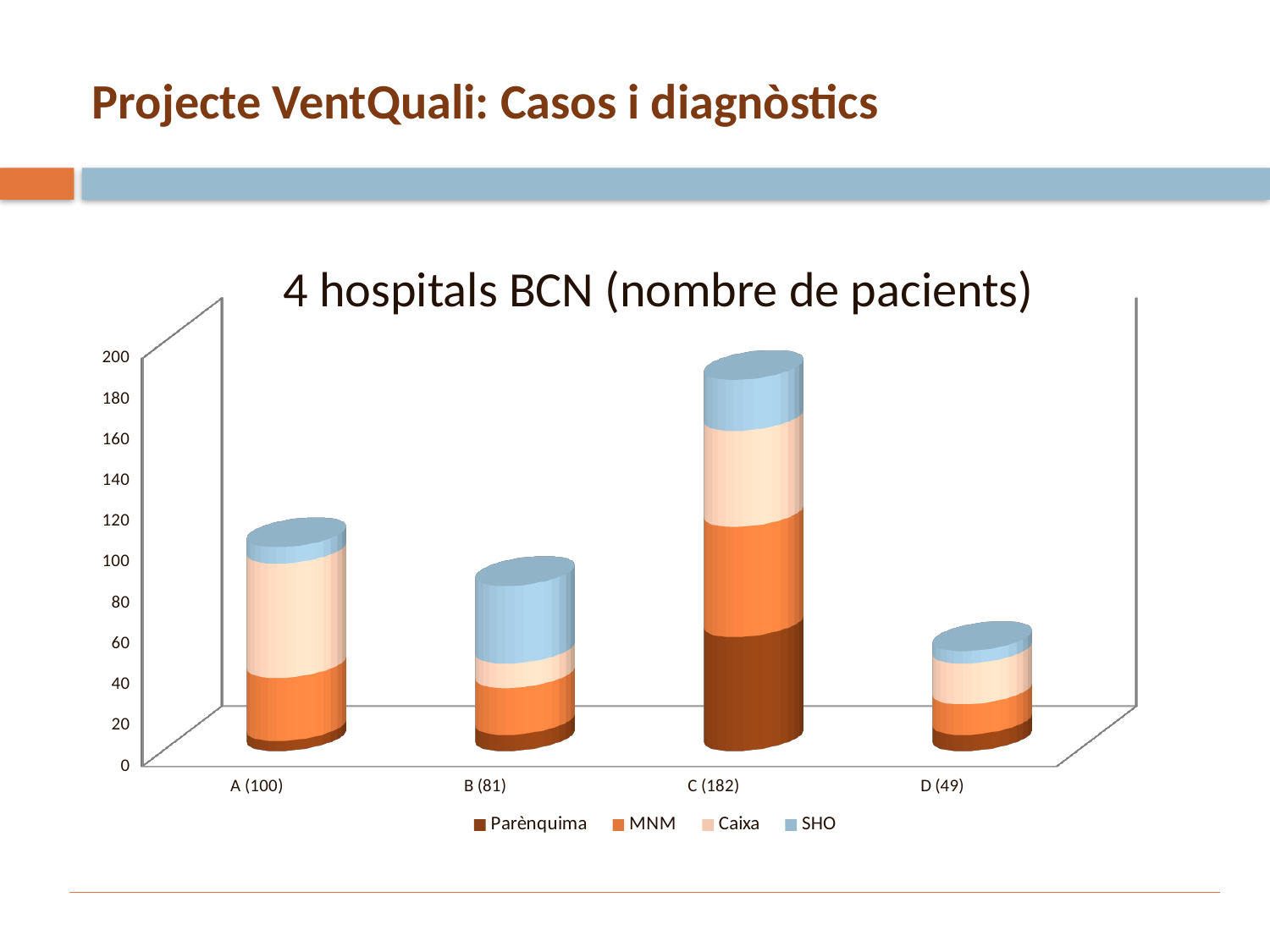
How many series does the legend list? 4 Which hospital has the highest total number of patients? C (182) Which hospital has the lowest total number of patients? D (49) How many hospitals (categories) are shown on the x axis? 4 What is the title of the chart? 4 hospitals BCN (nombre de pacients) What is the total number of patients for hospital D, as shown in its category label? 49 Which hospital has more patients in total, A or B? A (100) What type of chart is shown on the slide? Stacked bar chart Which series are listed in the legend? Parènquima, MNM, Caixa, SHO Is the total for hospital B greater or less than 100? less What is the difference between the total patients of hospital C and hospital A? 82 What is the total number of patients for hospital C, as shown in its category label? 182